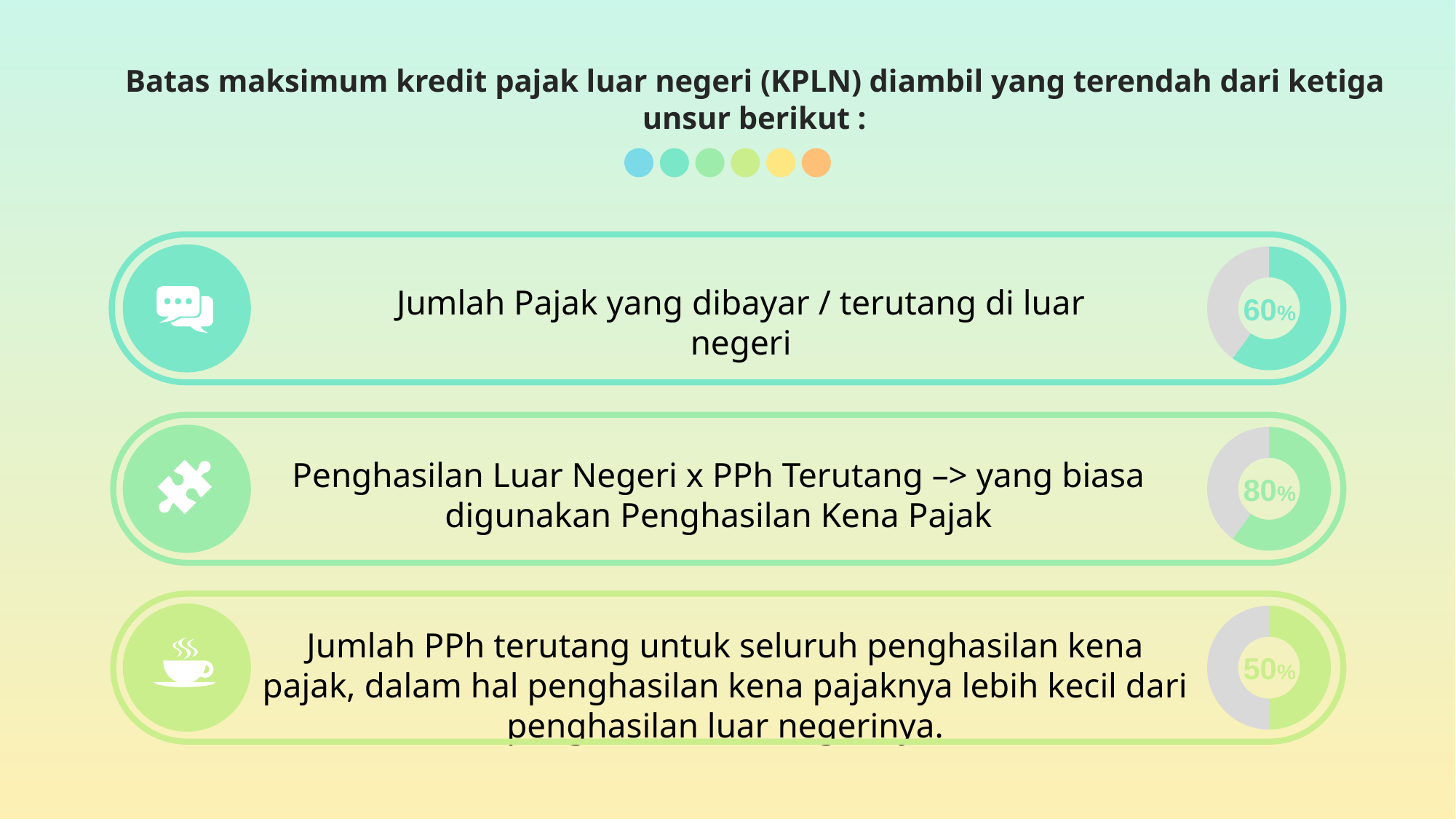
Which row's donut chart shows the lowest percentage? The bottom row (50%) What colour is the filled portion of the donut chart on the bottom row? Light green What is the difference between the percentage in the top-row donut chart and the bottom-row donut chart? 10% What percentage is shown in the donut chart on the middle row, next to 'Penghasilan Luar Negeri x PPh Terutang'? 80% Which is larger: the percentage in the top-row donut chart or the bottom-row donut chart? The top-row donut chart (60%) What percentage is shown in the donut chart on the top row, next to 'Jumlah Pajak yang dibayar / terutang di luar negeri'? 60% What is the difference between the percentage in the middle-row donut chart and the top-row donut chart? 20% What kind of chart is used to display the percentages on the right side of each row? Donut chart Is the percentage in the middle-row donut chart greater or less than 50%? greater What percentage is shown in the donut chart on the bottom row, next to 'Jumlah PPh terutang untuk seluruh penghasilan kena pajak'? 50% Which row's donut chart shows the highest percentage? The middle row (80%) How many donut charts are on the slide? 3